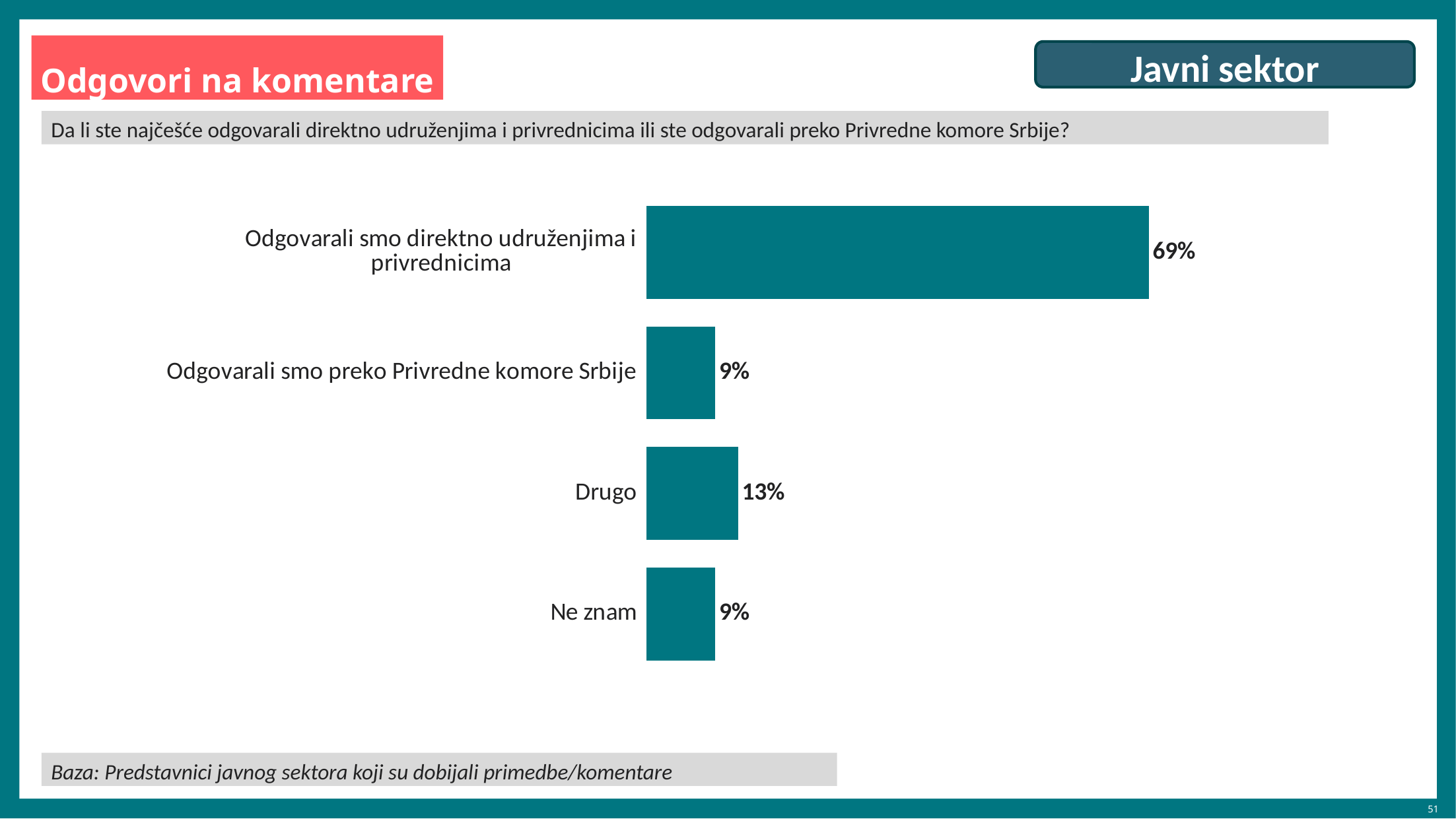
What is the title shown in the top-right box of the slide? Javni sektor What is the value for "Ne znam"? 9% What kind of chart is shown on the slide? Bar chart What is the value for "Odgovarali smo preko Privredne komore Srbije"? 9% What is the difference between the values for "Drugo" and "Ne znam"? 4% What is the value for "Odgovarali smo direktno udruženjima i privrednicima"? 69% What is the difference between the values for "Odgovarali smo direktno udruženjima i privrednicima" and "Drugo"? 56% Which category has the highest value? Odgovarali smo direktno udruženjima i privrednicima How many categories are shown in the chart? 4 What is the value for "Drugo"? 13% Which two categories share the same value? Odgovarali smo preko Privredne komore Srbije and Ne znam Which is larger, the value for "Drugo" or the value for "Odgovarali smo preko Privredne komore Srbije"? Drugo